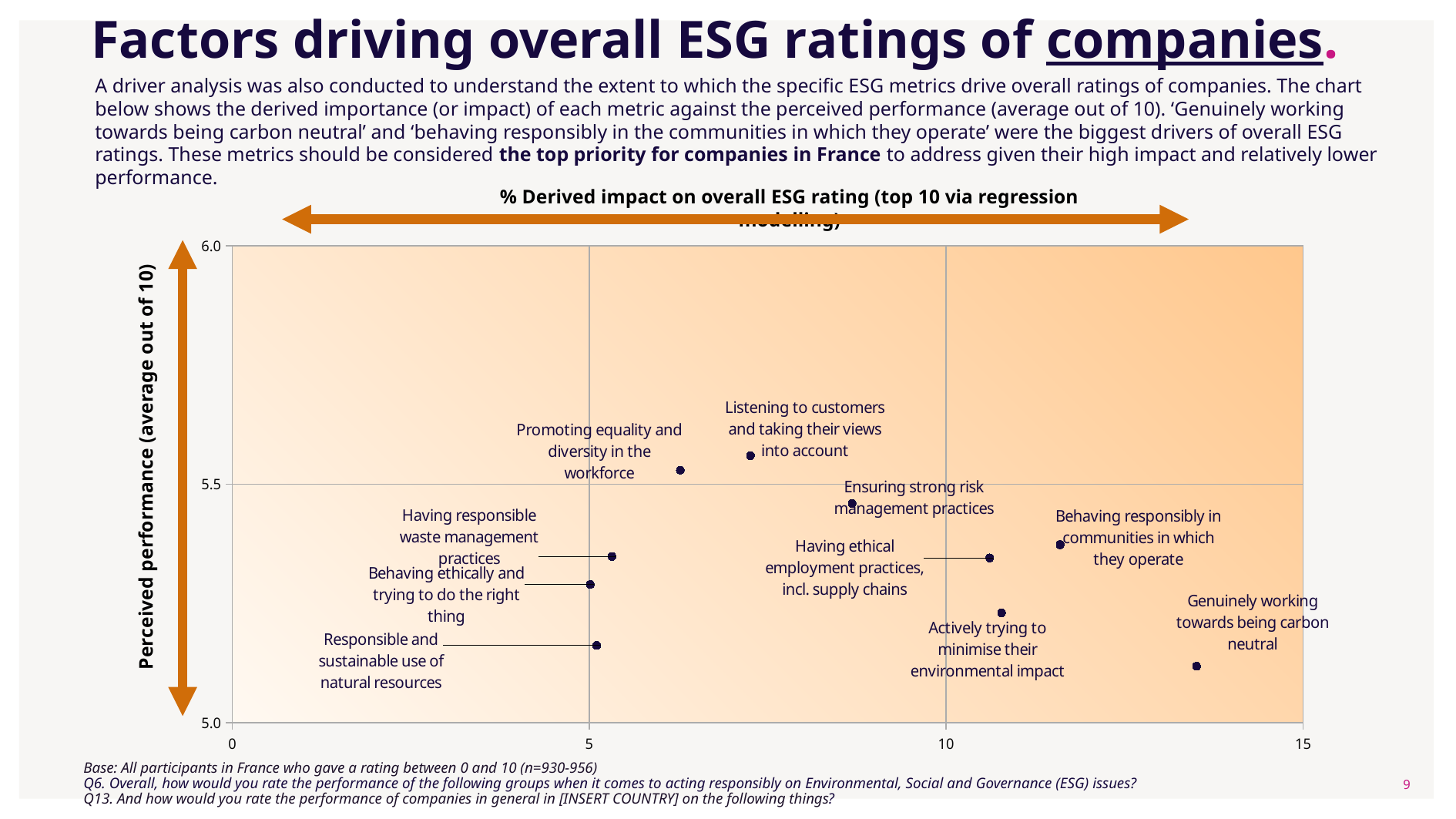
What is the label of the vertical axis of the chart? Perceived performance (average out of 10) Which metric has the highest derived impact on overall ESG rating (furthest right on the x axis)? Genuinely working towards being carbon neutral Which has a higher perceived performance: 'Listening to customers and taking their views into account' or 'Genuinely working towards being carbon neutral'? Listening to customers and taking their views into account Is the derived impact value for 'Behaving responsibly in communities in which they operate' greater or less than 10? greater Is the derived impact value for 'Listening to customers and taking their views into account' greater or less than 10? less Which has a higher derived impact on overall ESG rating: 'Genuinely working towards being carbon neutral' or 'Promoting equality and diversity in the workforce'? Genuinely working towards being carbon neutral Is the derived impact value for 'Genuinely working towards being carbon neutral' greater or less than 10? greater What kind of chart is shown on the slide? Scatter chart How many data points are plotted on the chart? 10